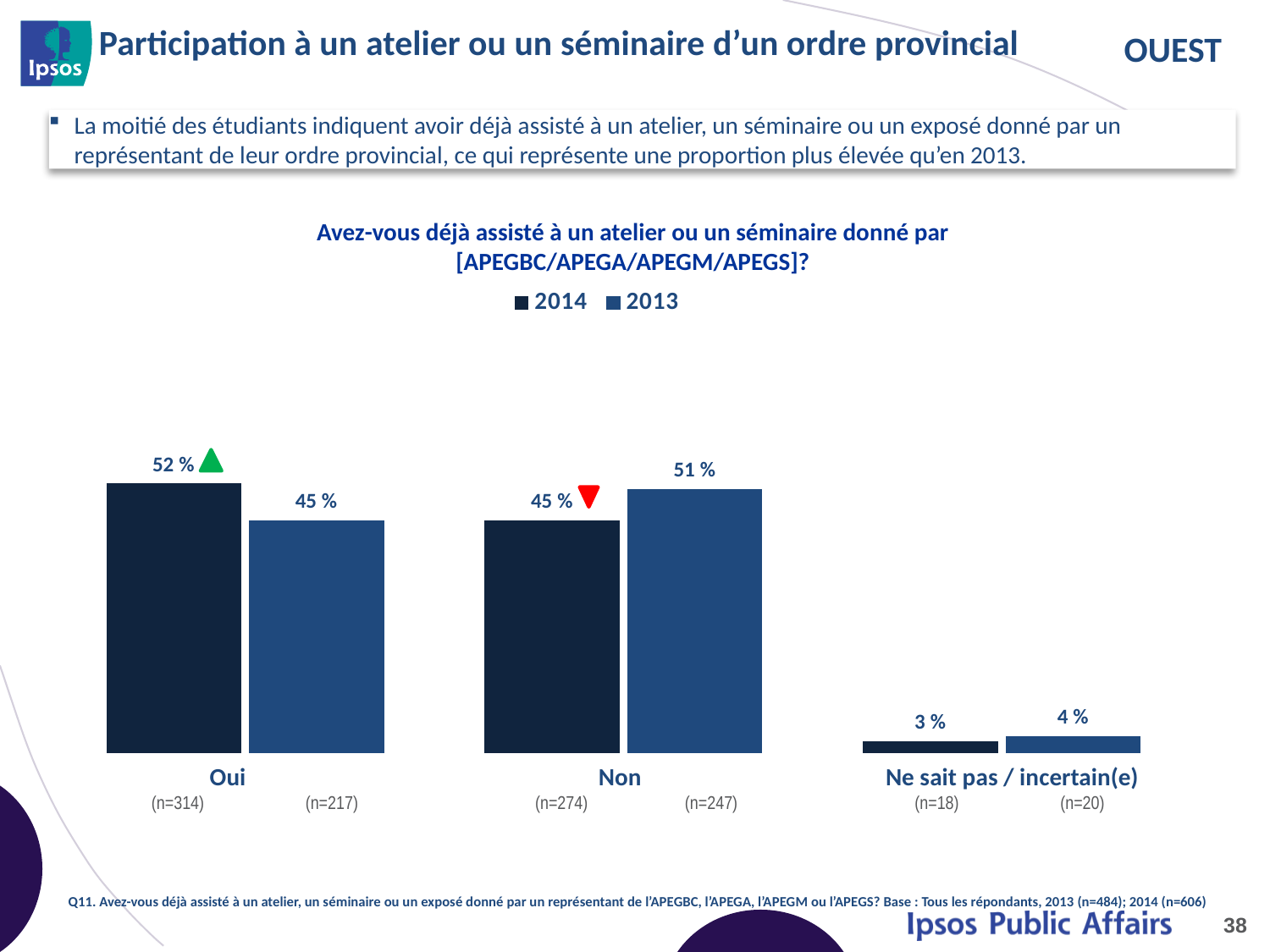
What is the 2013 value for "Non"? 51 % What kind of chart is shown on the slide? bar chart What is the 2014 value for "Non"? 45 % Which category has the highest 2014 value? Oui For "Non", which year has the larger value, 2014 or 2013? 2013 Which category has the lowest 2013 value? Ne sait pas / incertain(e) How many series does the legend list? 2 What is the 2013 value for "Oui"? 45 % What is the 2014 value for "Ne sait pas / incertain(e)"? 3 % What is the 2014 value for "Oui"? 52 % What is the difference between the 2014 and 2013 values for "Oui"? 7 % How many categories are shown on the x axis of the chart? 3